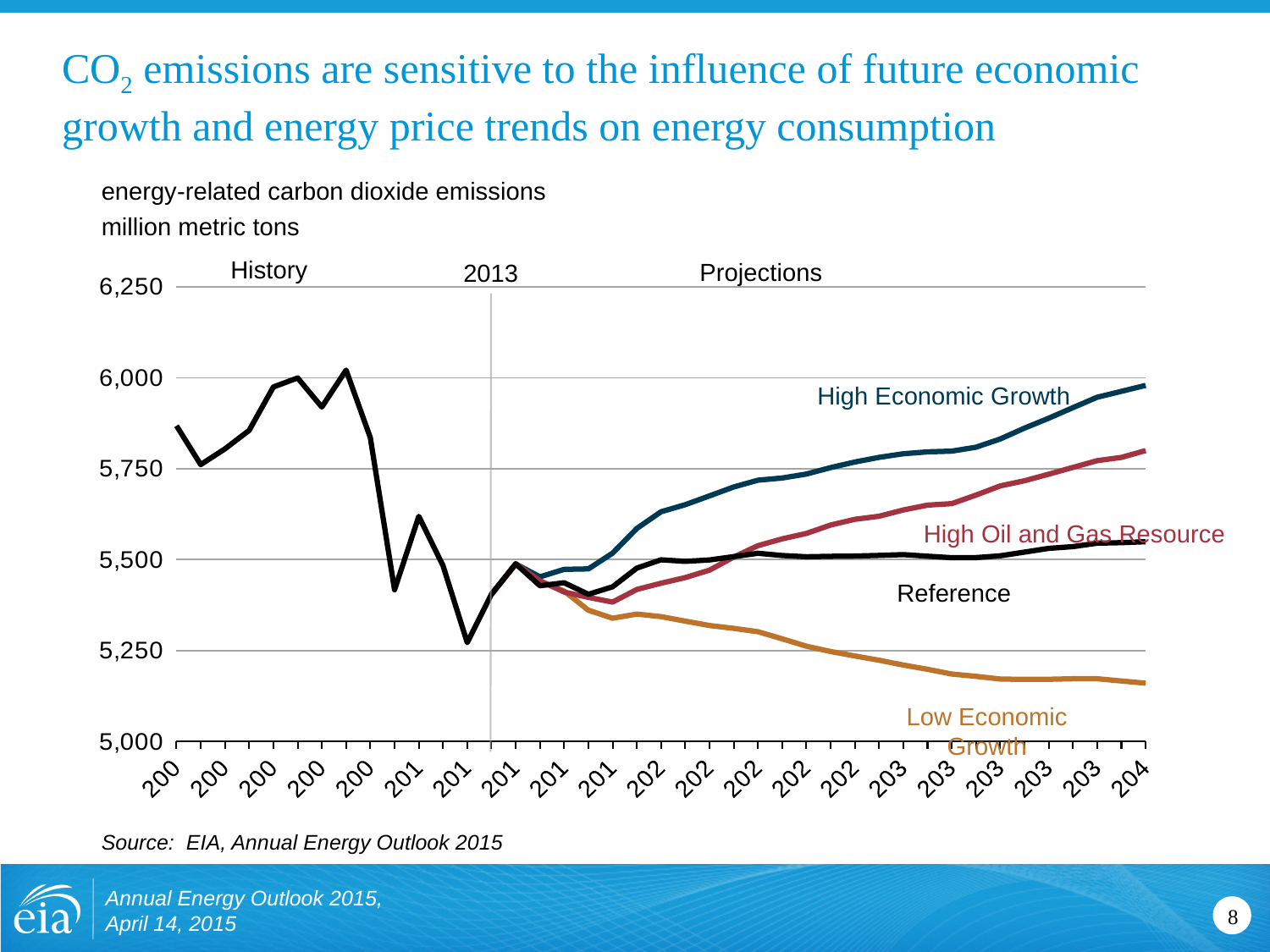
How many labeled projection scenarios are plotted on the chart? 4 At the end of the projection period, which is larger: High Oil and Gas Resource or Reference? High Oil and Gas Resource Do emissions in the High Economic Growth scenario rise or fall over the projection period? rise What is the title of the chart? energy-related carbon dioxide emissions Is the Reference value at the end of the projection period greater or less than 5,500? greater Which projection scenario has the lowest emissions at the end of the projection period? Low Economic Growth Which projection scenario has the highest emissions at the end of the projection period? High Economic Growth What kind of chart is shown on the slide? line chart In what unit are the emissions on the chart measured? million metric tons Is the High Economic Growth value at the end of the projection period greater or less than 5,750? greater Is the Low Economic Growth value at the end of the projection period greater or less than 5,250? less Do emissions in the Low Economic Growth scenario rise or fall over the projection period? fall